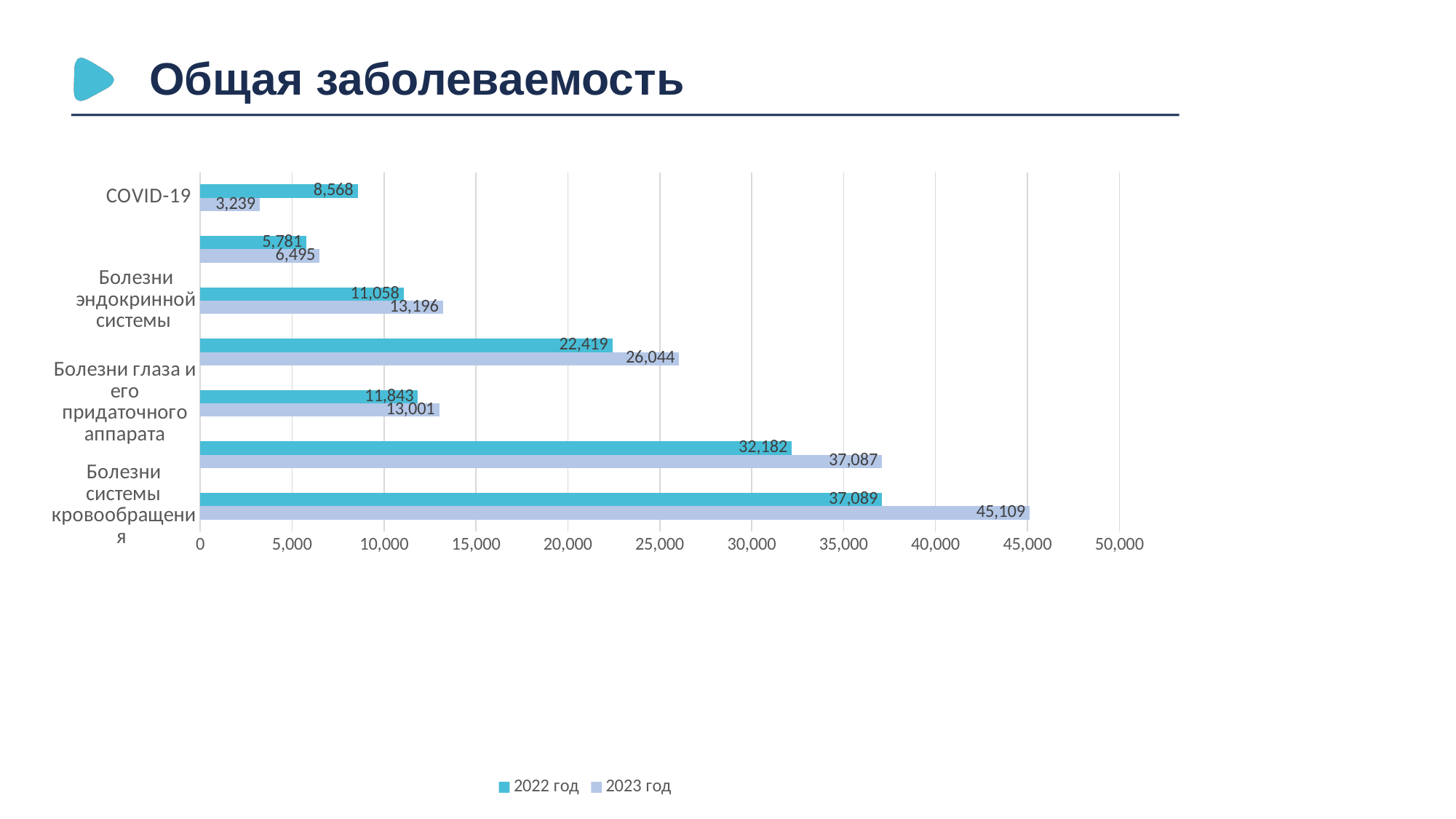
How many series does the legend list? 2 Which category has the lowest 2023 год value? COVID-19 Which category has the highest 2023 год value? Болезни системы кровообращения What is the difference between the 2023 год and 2022 год values for Болезни системы кровообращения? 8,020 What is the value for COVID-19 in the 2023 год series? 3,239 For COVID-19, which series has the larger value, 2022 год or 2023 год? 2022 год By how much does the 2022 год value for COVID-19 exceed the 2023 год value? 5,329 What is the 2023 год value for Болезни эндокринной системы? 13,196 What type of chart is shown on the slide? Bar chart What is the 2023 год value for Болезни глаза и его придаточного аппарата? 13,001 What is the 2022 год value for Болезни системы кровообращения? 37,089 What is the value for COVID-19 in the 2022 год series? 8,568